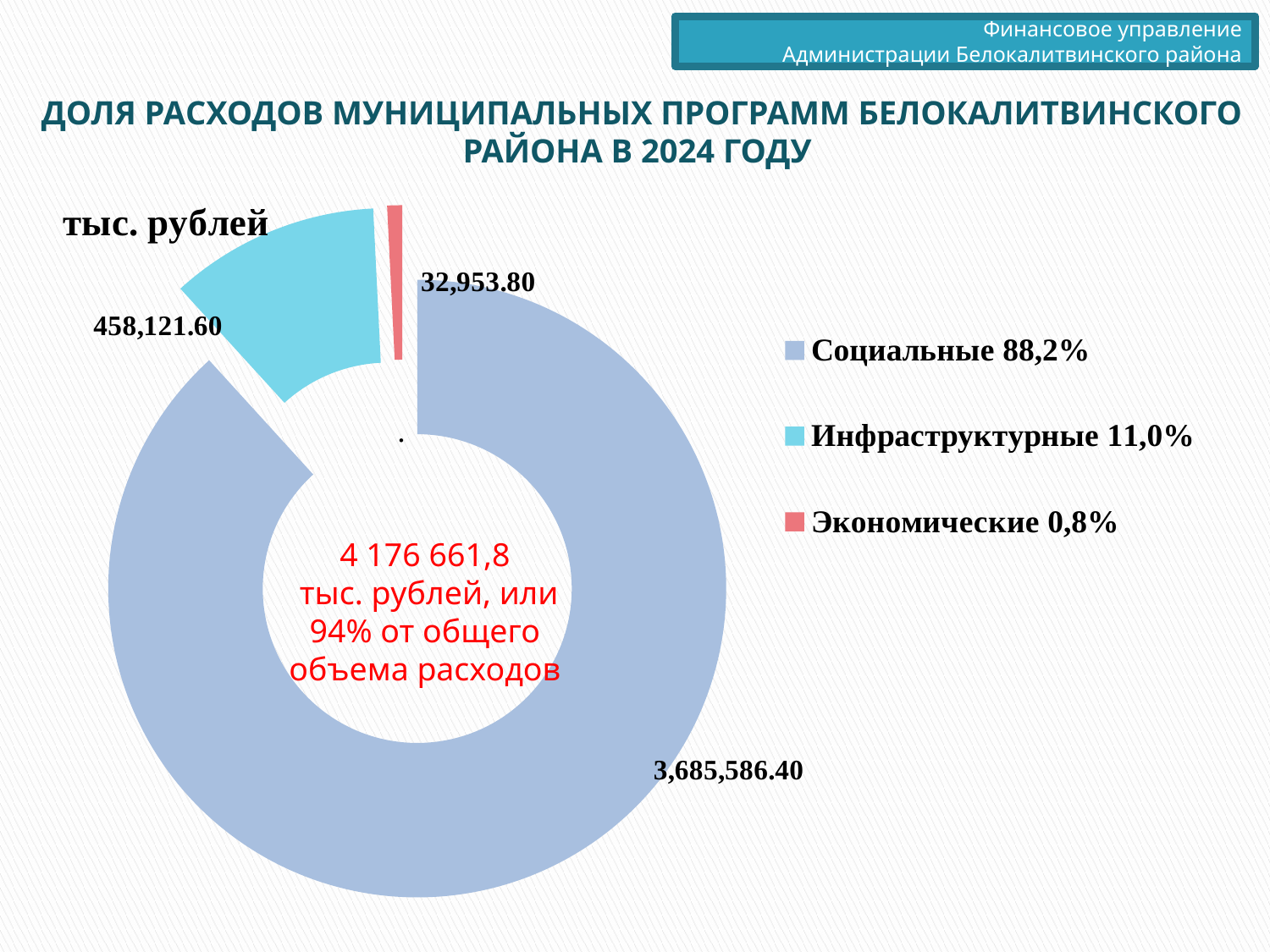
What share of the pie does Инфраструктурные represent, according to the legend? 11,0% What kind of chart is shown on the slide? Pie chart (doughnut) What is the difference between the values for Инфраструктурные and Экономические? 425,167.80 What unit is stated for the values in the chart? тыс. рублей What is the value for Социальные? 3,685,586.40 How many categories does the chart show? 3 Which category has the lowest value? Экономические What is the value for Инфраструктурные? 458,121.60 What is the difference between the values for Социальные and Инфраструктурные? 3,227,464.80 Which is larger, the value for Инфраструктурные or the value for Экономические? Инфраструктурные Which category has the highest value? Социальные What is the value for Экономические? 32,953.80